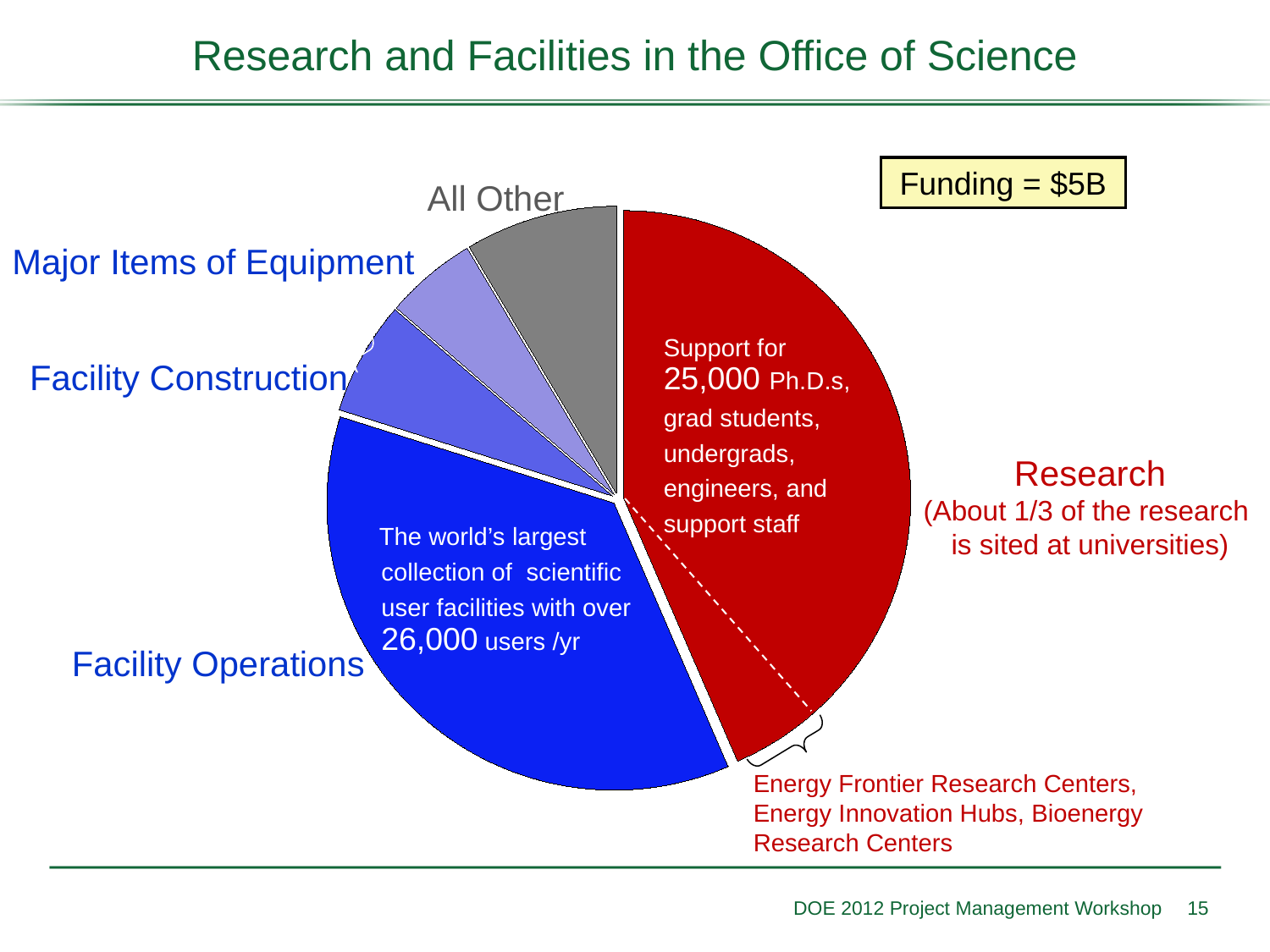
Which category is shown in grey on the pie chart? All Other Which category is shown in red on the pie chart? Research What is the total funding shown for the pie chart? $5B Which slice is larger, Research or Facility Operations? Research Which slice is larger, Facility Operations or All Other? Facility Operations What is the title of the slide containing the pie chart? Research and Facilities in the Office of Science Which category has the largest slice of the pie chart? Research Which slice is larger, All Other or Facility Construction? All Other What kind of chart is shown on the slide? pie chart How many slices does the pie chart have? 5